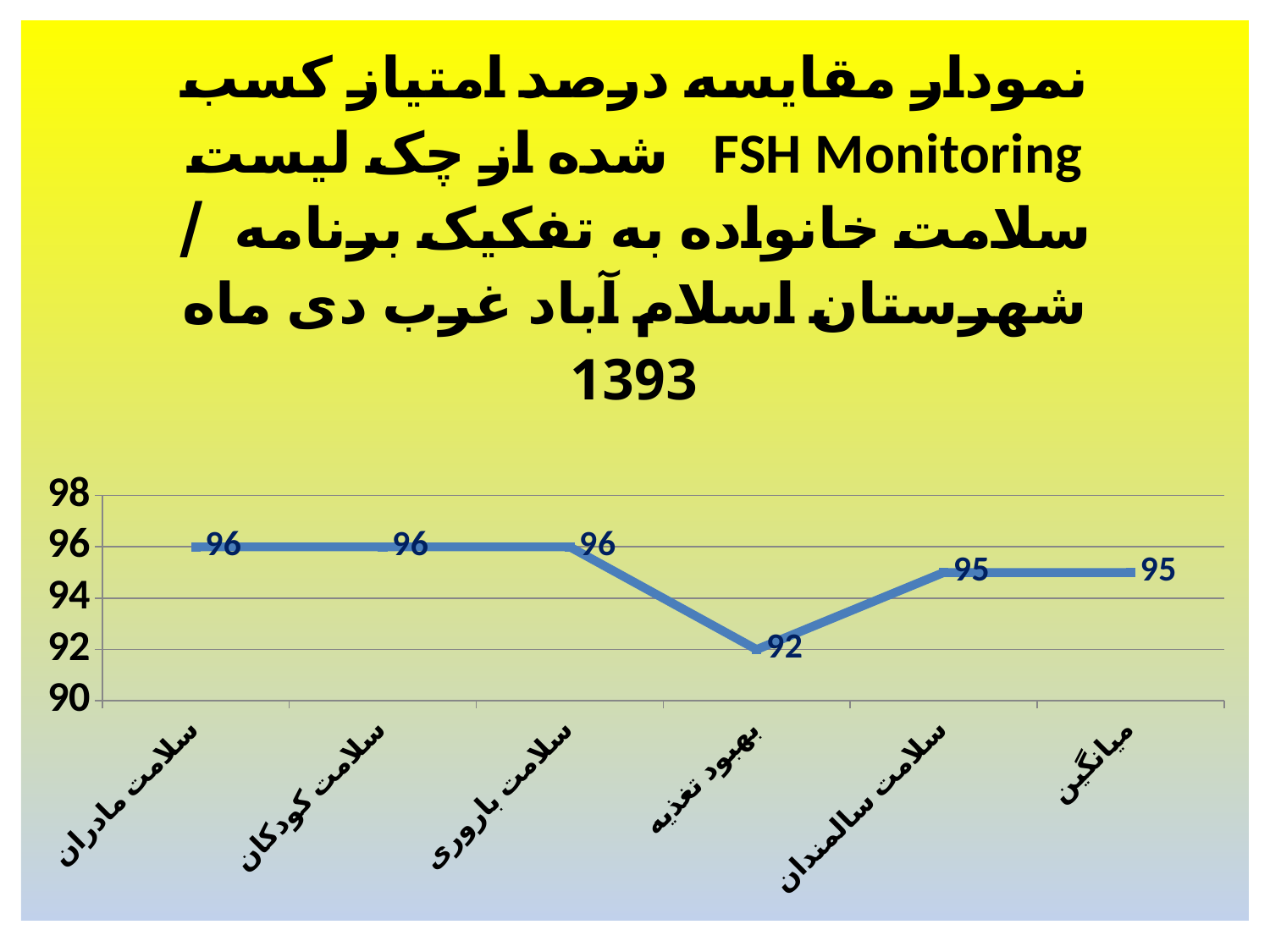
Which category has the lowest value? بهبود تغذیه Which is larger, the value for سلامت کودکان or the value for میانگین? سلامت کودکان What is the difference between the values for سلامت سالمندان and بهبود تغذیه? 3 What kind of chart is shown on the slide? line chart How many categories are plotted on the x axis? 6 What is the value for میانگین? 95 What is the value for بهبود تغذیه? 92 Is the value for بهبود تغذیه greater or less than 94? less What is the value for سلامت مادران? 96 What is the difference between the values for سلامت باروری and بهبود تغذیه? 4 What is the value for سلامت سالمندان? 95 Do the values rise or fall from سلامت باروری to بهبود تغذیه? fall